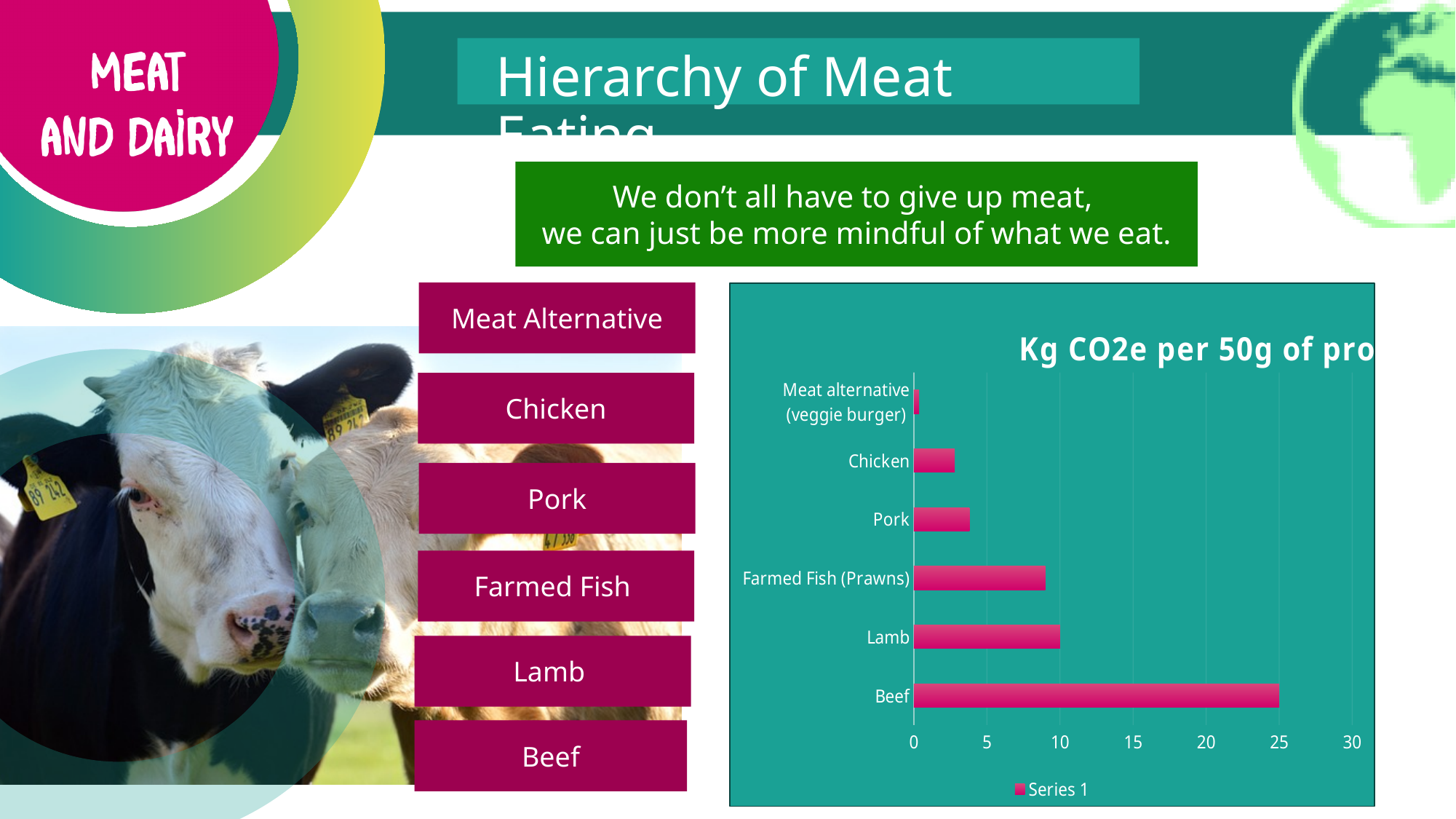
Is the value for Chicken greater or less than 5? less Is the value for Pork greater or less than 5? less What is the name of the series listed in the chart legend? Series 1 How many series does the chart legend list? 1 Which is larger, the value for Lamb or the value for Farmed Fish (Prawns)? Lamb What is the value for Lamb in the bar chart? 10 Which category has the lowest value in the bar chart? Meat alternative (veggie burger) How many categories does the bar chart show? 6 Which category has the highest value in the bar chart? Beef Is the value for Farmed Fish (Prawns) greater or less than 5? greater What is the value for Beef in the bar chart? 25 What kind of chart is shown on the slide? bar chart